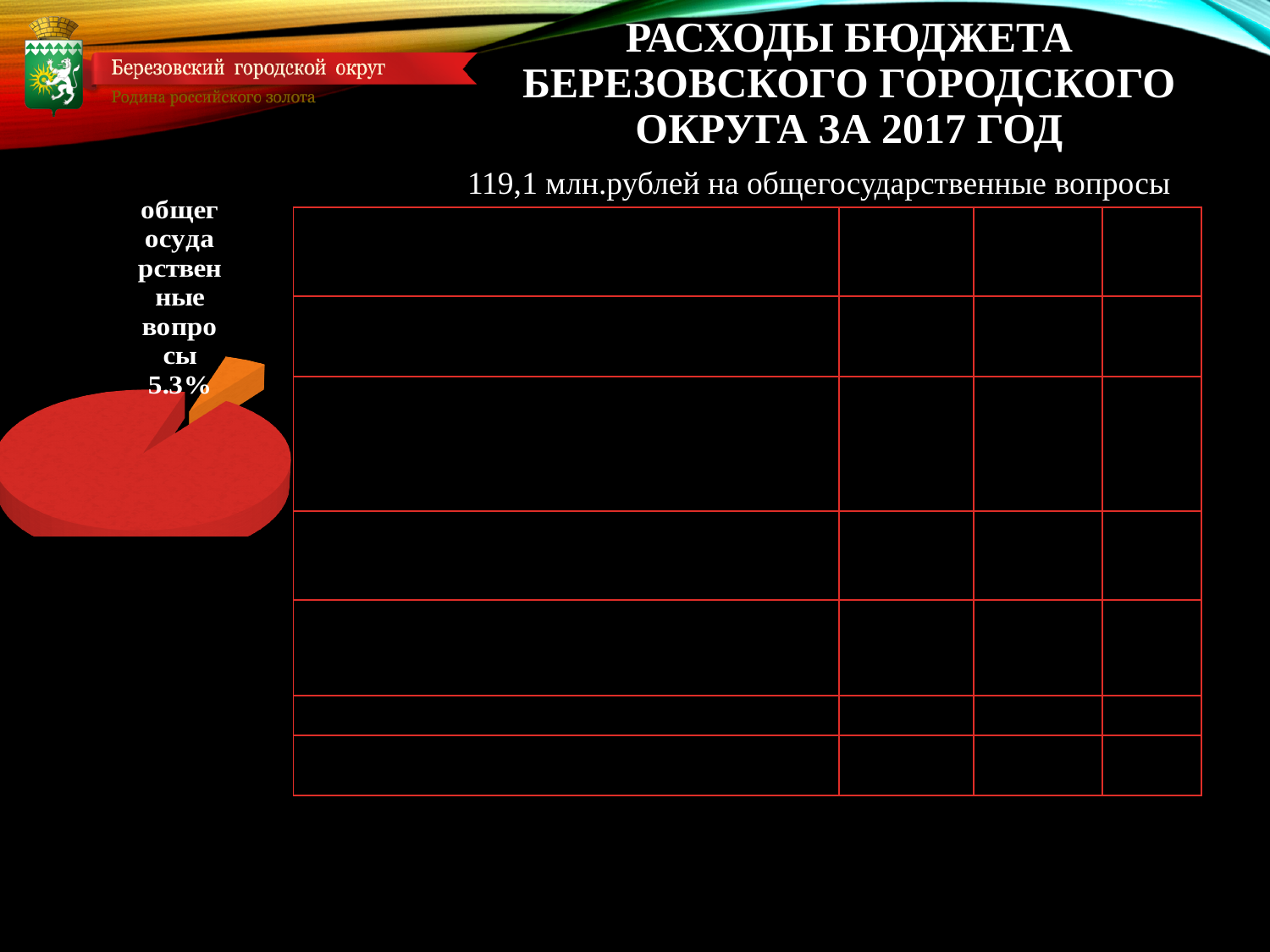
What is the title of the slide containing the pie chart? РАСХОДЫ БЮДЖЕТА БЕРЕЗОВСКОГО ГОРОДСКОГО ОКРУГА ЗА 2017 ГОД How many slices are visible in the pie chart? 2 What colour is the exploded slice labelled "общегосударственные вопросы"? orange What share of the pie does the slice labelled "общегосударственные вопросы" represent? 5.3% Is the share for "общегосударственные вопросы" greater or less than 50%? less What kind of chart is shown on the slide? pie chart Which slice of the pie is larger: the labelled "общегосударственные вопросы" slice or the unlabelled red remainder? the unlabelled red remainder